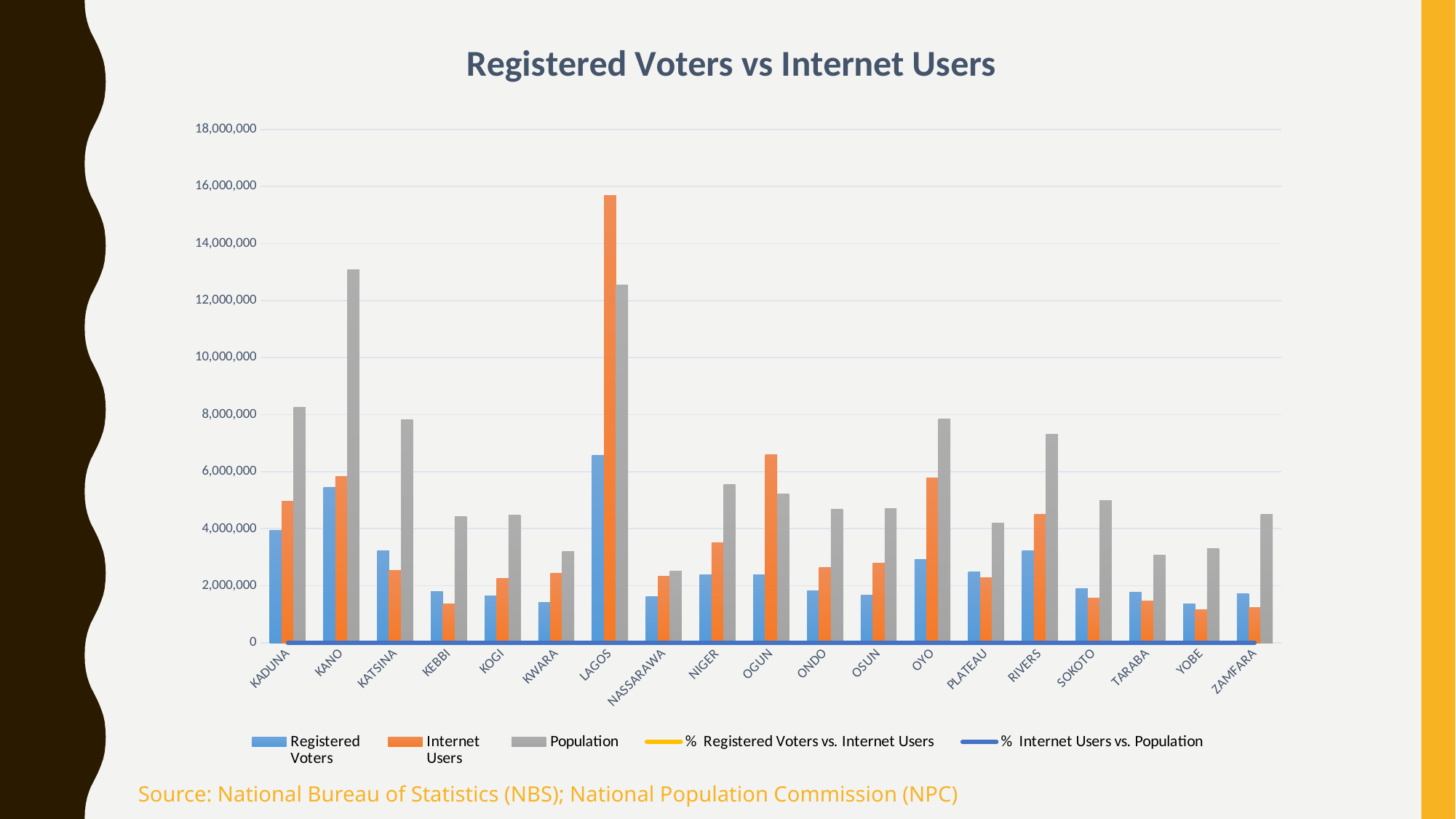
Is the Internet Users value for LAGOS greater or less than 14,000,000? greater Which state has the highest Internet Users value? LAGOS Which state has the lowest Population value? NASSARAWA How many series does the legend list? 5 Which state has the highest Population value? KANO Is the Internet Users value for KEBBI greater or less than 2,000,000? less What is the title of the chart? Registered Voters vs Internet Users What kind of chart is shown on the slide? bar chart Which state has the highest Registered Voters value? LAGOS How many states are shown on the x axis of the chart? 19 For OGUN, which is larger: Internet Users or Population? Internet Users Is the Population value for KADUNA greater or less than 8,000,000? greater